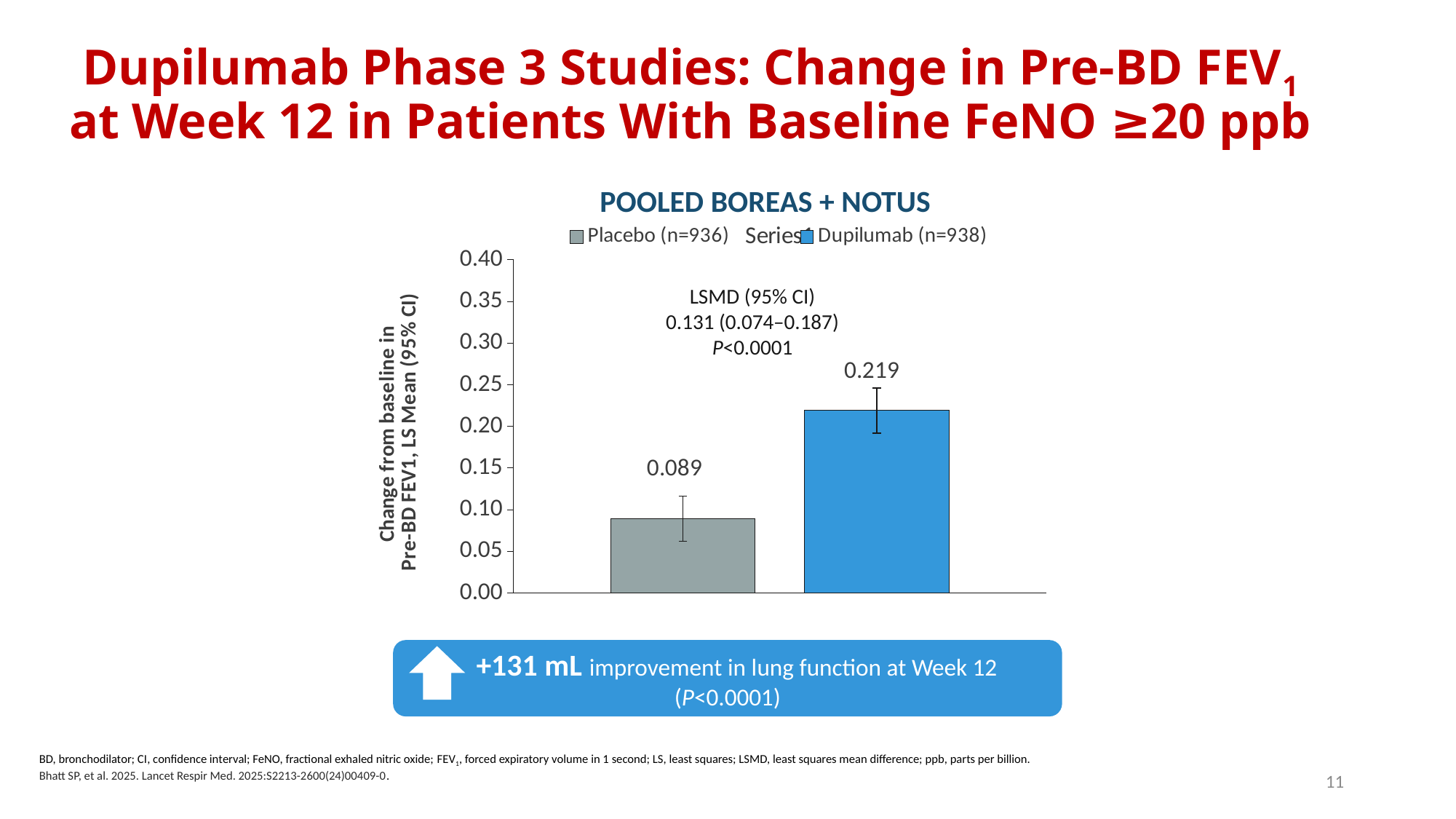
Is the value for Dupilumab (n=938) greater or less than 0.20? greater Which group has the lower change from baseline in pre-BD FEV1? Placebo (n=936) What is the title of the chart? POOLED BOREAS + NOTUS What kind of chart is shown on the slide? Bar chart What is the LSMD (95% CI) shown on the chart? 0.131 (0.074–0.187) Is the value for Placebo (n=936) greater or less than 0.10? less What is the maximum value shown on the y-axis of the chart? 0.40 What is the change from baseline in pre-BD FEV1 for the Dupilumab (n=938) group? 0.219 How many bars are plotted in the chart? 2 Which group has the higher change from baseline in pre-BD FEV1? Dupilumab (n=938) What is the change from baseline in pre-BD FEV1 for the Placebo (n=936) group? 0.089 What is the difference between the Dupilumab and Placebo values for change from baseline in pre-BD FEV1? 0.130